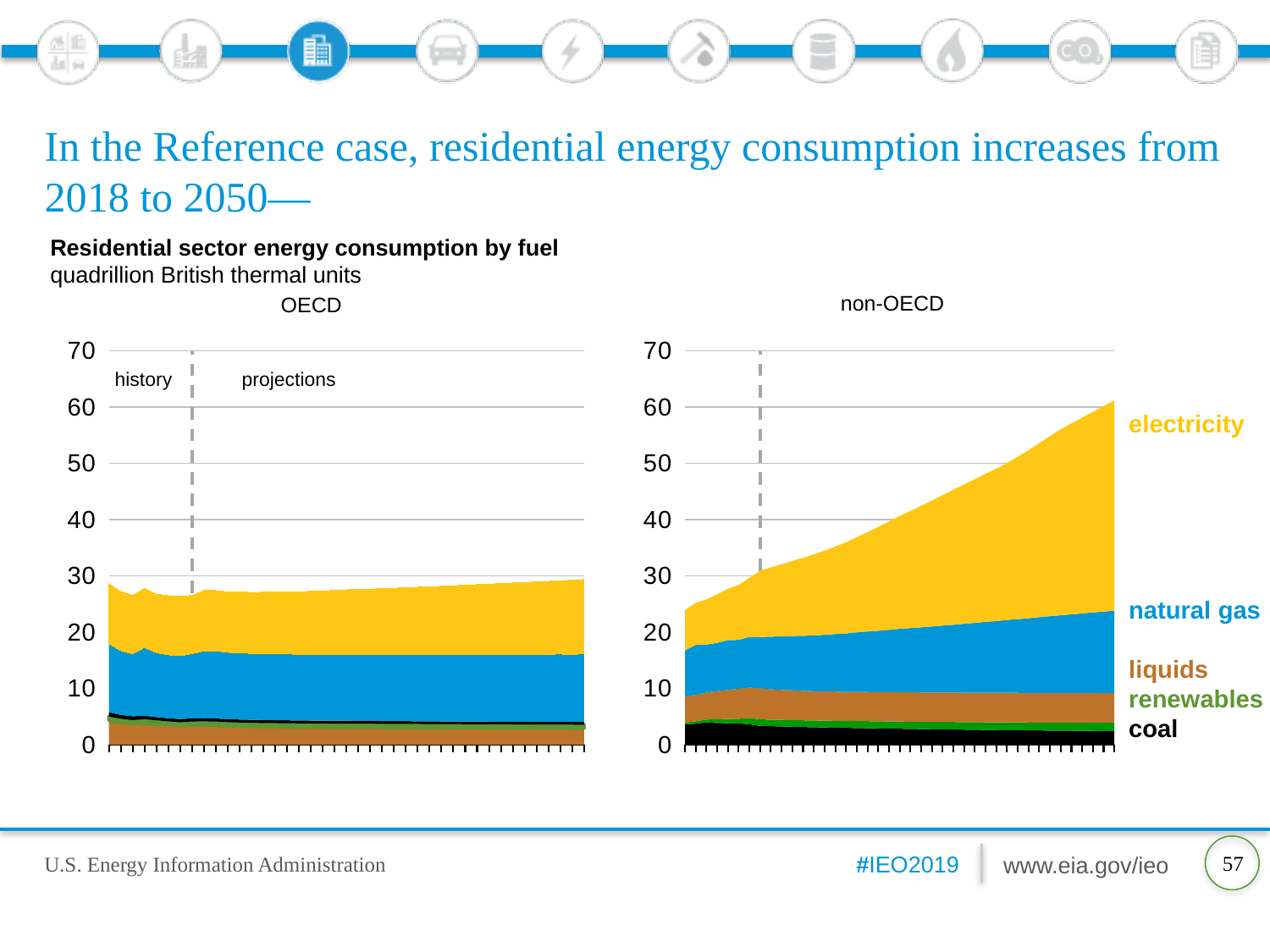
What kind of chart is the OECD chart? stacked area chart In the OECD chart, is the total residential energy consumption at the end of the projection period greater or less than 40? less What is the highest value shown on the y axis of the OECD chart? 70 How many fuel series are shown in the non-OECD chart's legend? 5 Which chart shows the higher total residential energy consumption at the end of the projection period, OECD or non-OECD? non-OECD In the non-OECD chart, does total residential energy consumption rise or fall over the projection period? rise In the non-OECD chart, which fuel accounts for the largest share of consumption at the end of the projection period? electricity In the non-OECD chart, is the total residential energy consumption at the start of the history period greater or less than 30? less In the non-OECD chart, is the total residential energy consumption at the end of the projection period greater or less than 50? greater In the OECD chart, which fuel accounts for the largest share of consumption at the end of the projection period? electricity What is the title of the charts on the slide? Residential sector energy consumption by fuel What unit is used on the y axis of both charts? quadrillion British thermal units